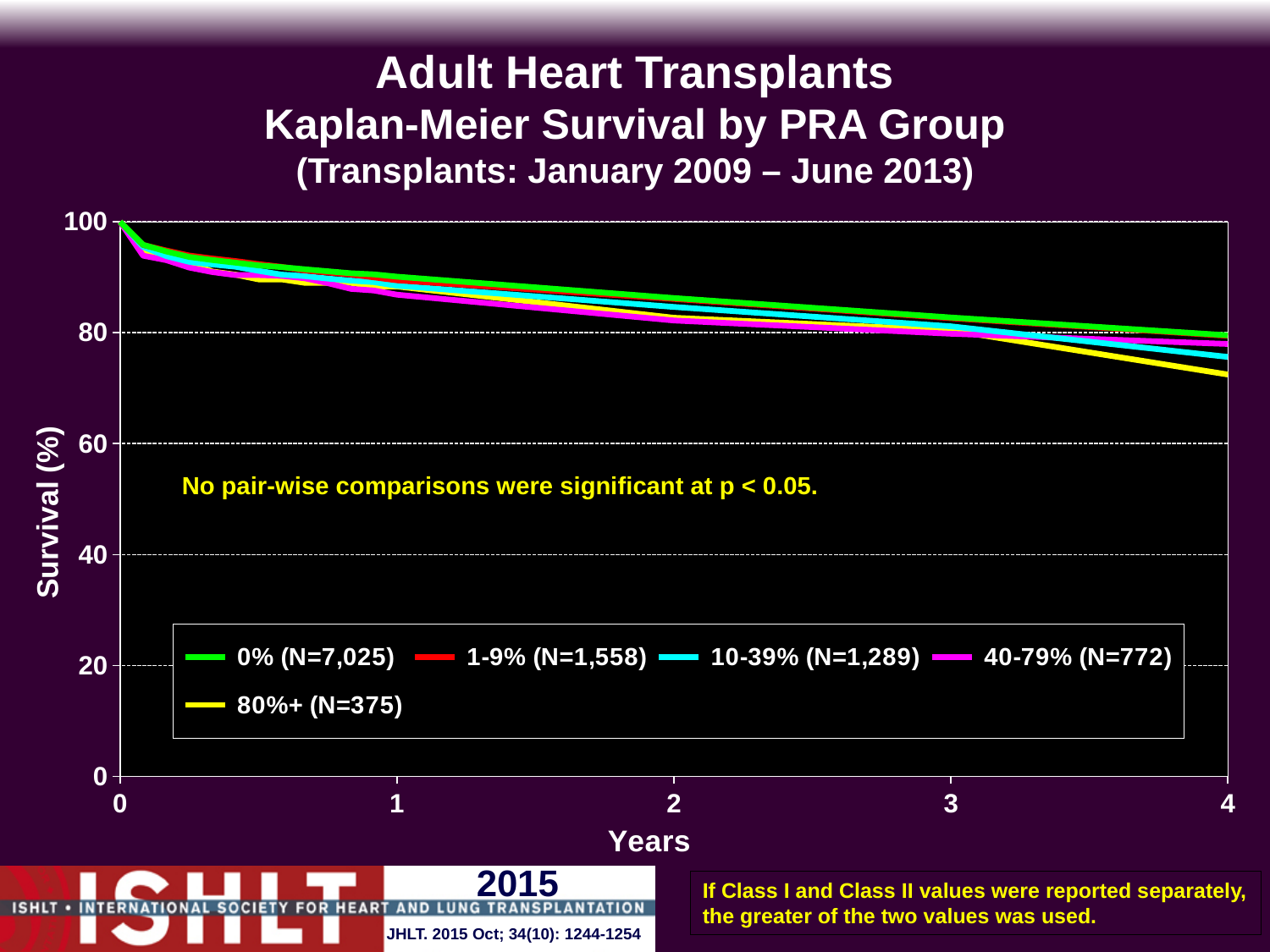
What is the label of the y axis? Survival (%) Which PRA group has the lowest survival at 4 years? 80%+ (N=375) Is the survival for the 0% PRA group at 1 year greater or less than 80? greater Is the survival for the 40-79% PRA group at 1 year greater or less than 100? less How many PRA groups (series) does the legend list? 5 What is the N for the 0% PRA group shown in the legend? 7,025 What is the N for the 80%+ PRA group shown in the legend? 375 Do the survival curves rise or fall as years since transplant increase? fall At 4 years, which group has higher survival: the 0% PRA group or the 80%+ PRA group? 0% PRA group What is the maximum value shown on the x axis (Years)? 4 Is the survival for the 80%+ PRA group at 4 years greater or less than 80? less What kind of chart is shown on the slide? line chart